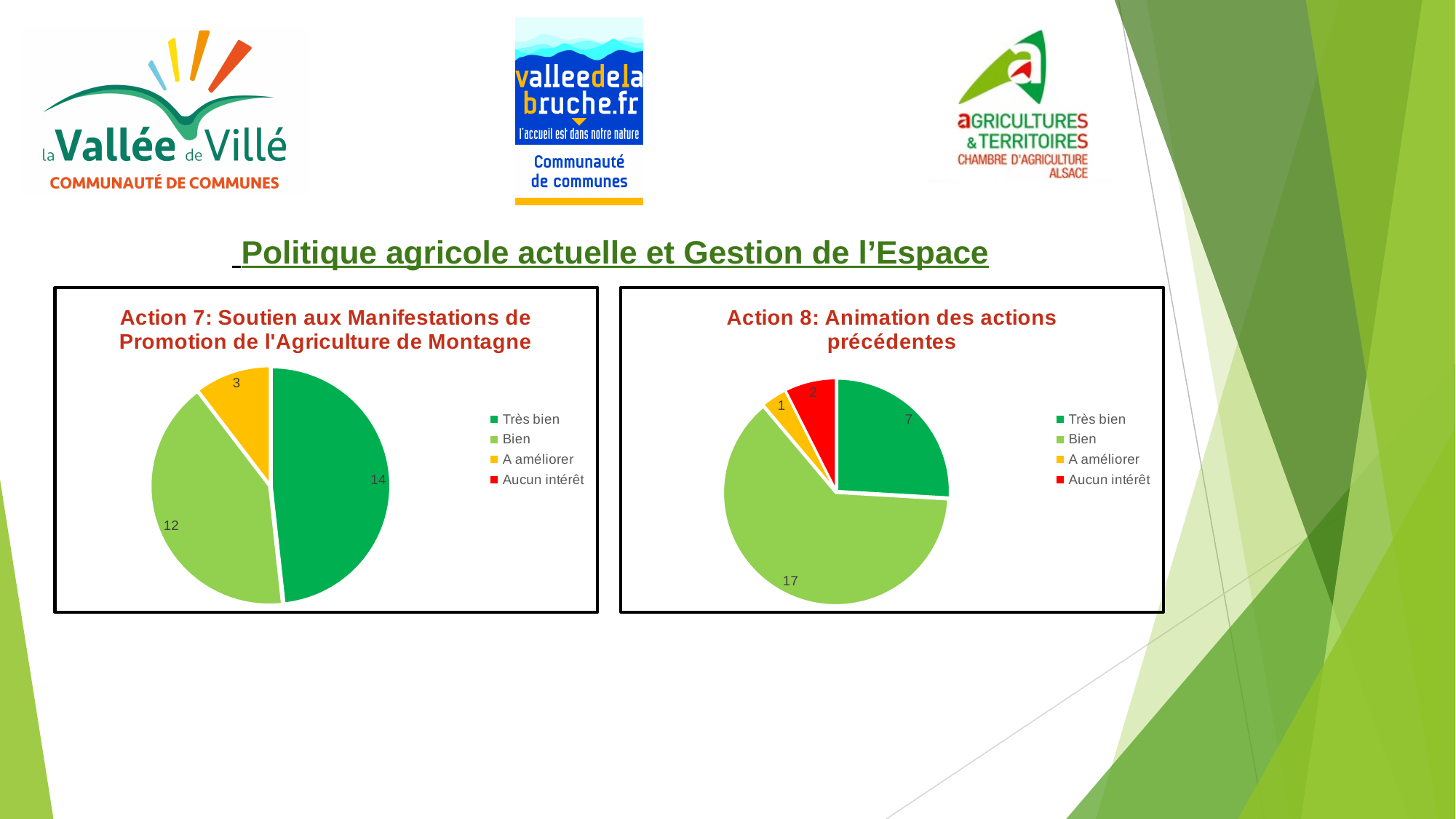
In the Action 8 chart, which category has the smallest slice? A améliorer In the Action 7 chart, what is the value for A améliorer? 3 In the Action 8 chart, what is the value for Bien? 17 In the Action 7 chart, what is the value for Très bien? 14 In the Action 8 chart, what is the value for Aucun intérêt? 2 How many entries does the legend of the Action 7 chart list? 4 What type of chart is used for Action 8? Pie chart In the Action 8 chart, what colour is the Aucun intérêt slice? Red In the Action 7 chart, which category has the largest slice? Très bien In the Action 8 chart, what is the difference between Bien and Très bien? 10 In the Action 8 chart, what is the total of all the slices? 27 In the Action 7 chart, which is larger, Bien or A améliorer? Bien